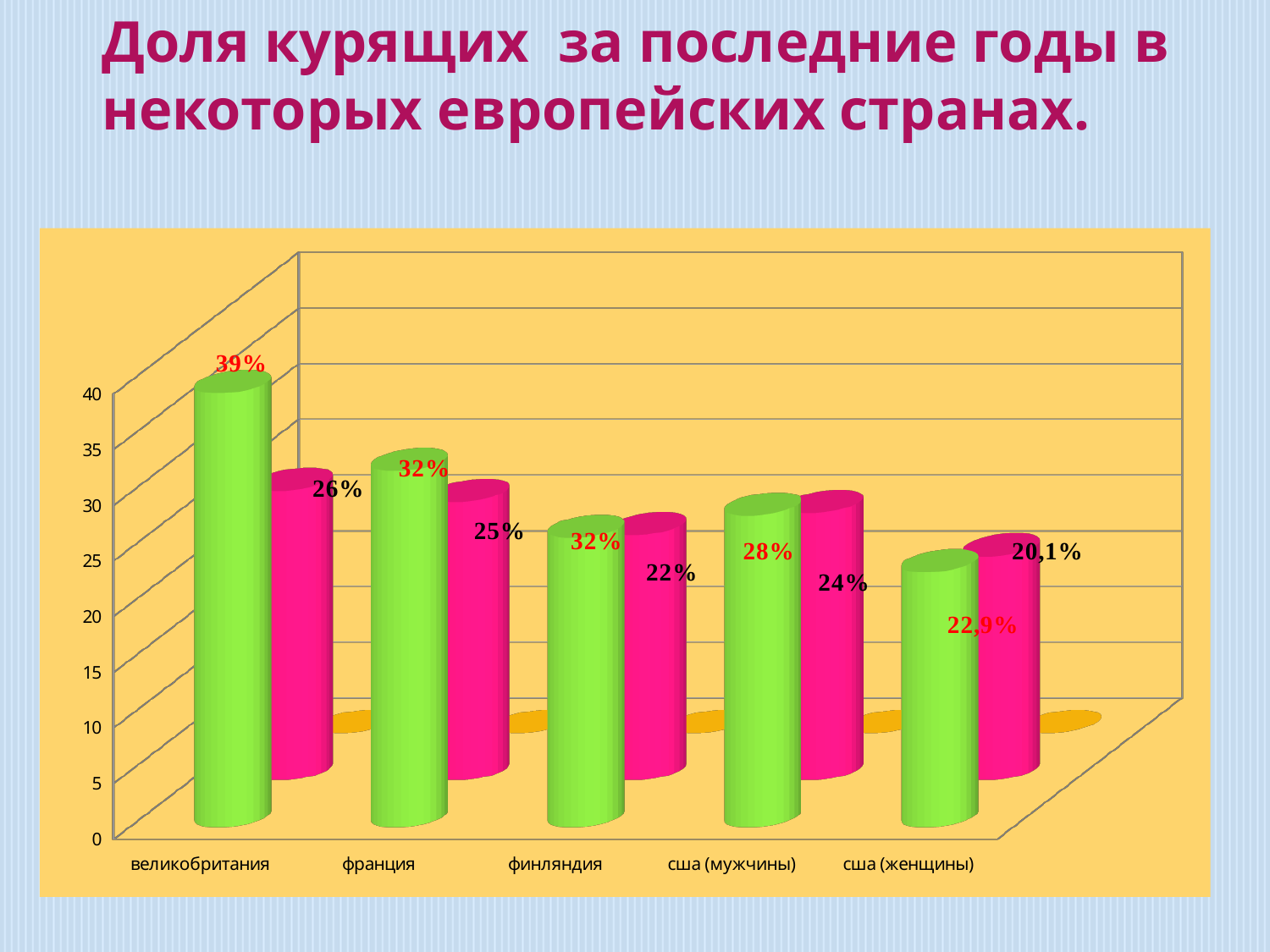
What is the value of the pink bar for великобритания? 26% What is the value of the pink bar for сша (женщины)? 20,1% What kind of chart is shown on the slide? bar chart What is the value of the pink bar for франция? 25% What is the value of the green bar for великобритания? 39% Which category has the lowest pink bar? сша (женщины) Which category has the highest green bar? великобритания How many categories are shown on the x axis of the chart? 5 What is the title of the chart on the slide? Доля курящих за последние годы в некоторых европейских странах. Which is larger for сша (мужчины): the green bar or the pink bar? the green bar What is the value of the green bar for сша (женщины)? 22,9%